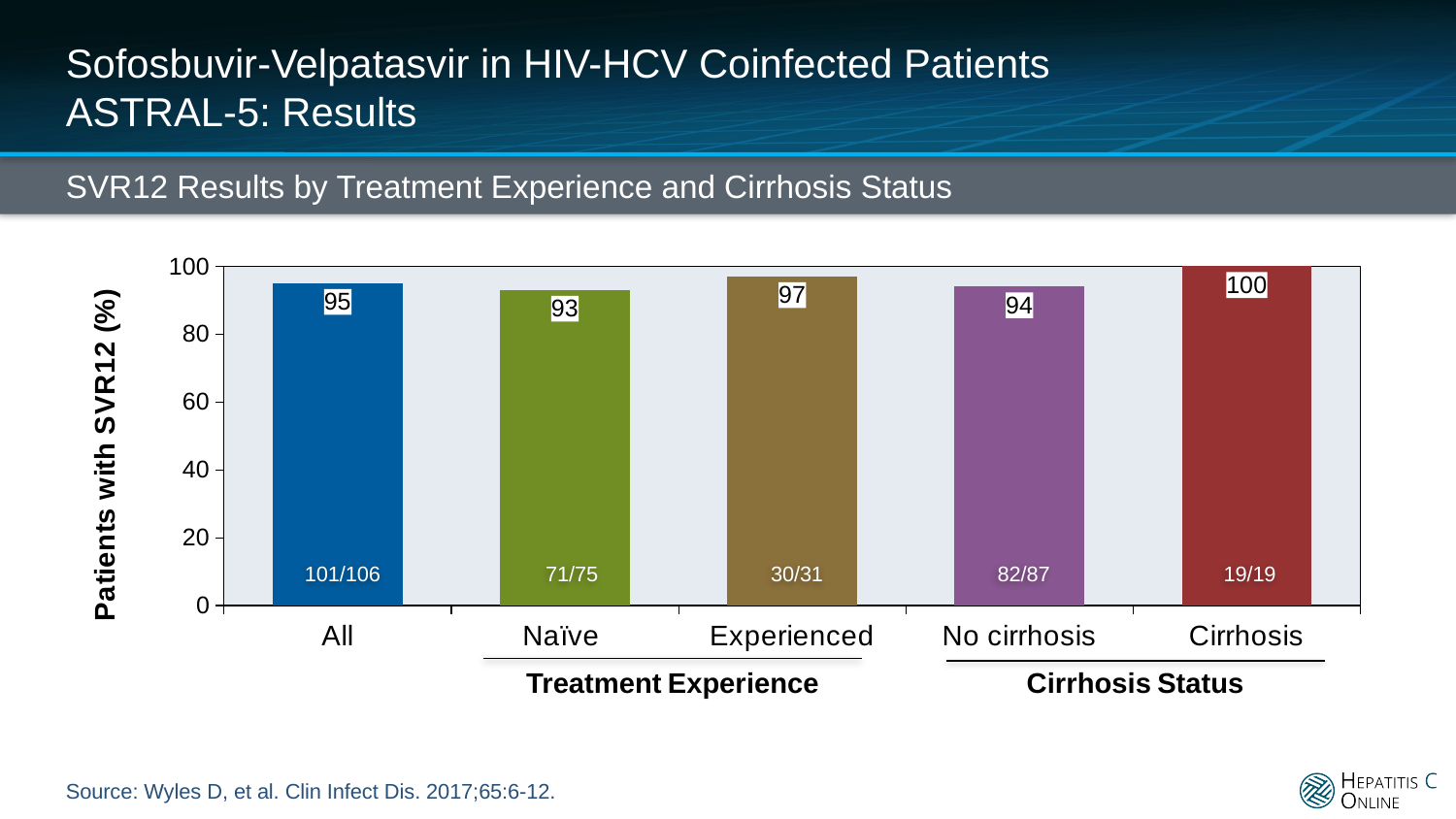
What fraction of patients is shown inside the Experienced bar? 30/31 What is the difference in SVR12 rate between the Cirrhosis and No cirrhosis groups? 6 What is the SVR12 rate for the All group? 95 What fraction of patients is shown inside the No cirrhosis bar? 82/87 What is the SVR12 rate for the Cirrhosis group? 100 Which category has the lowest SVR12 rate? Naïve How many bars are shown in the chart? 5 Which has a higher SVR12 rate, Naïve or Experienced? Experienced Which category has the highest SVR12 rate? Cirrhosis What kind of chart is shown on the slide? Bar chart What is the label of the y axis? Patients with SVR12 (%) What is the SVR12 rate for the Naïve group? 93